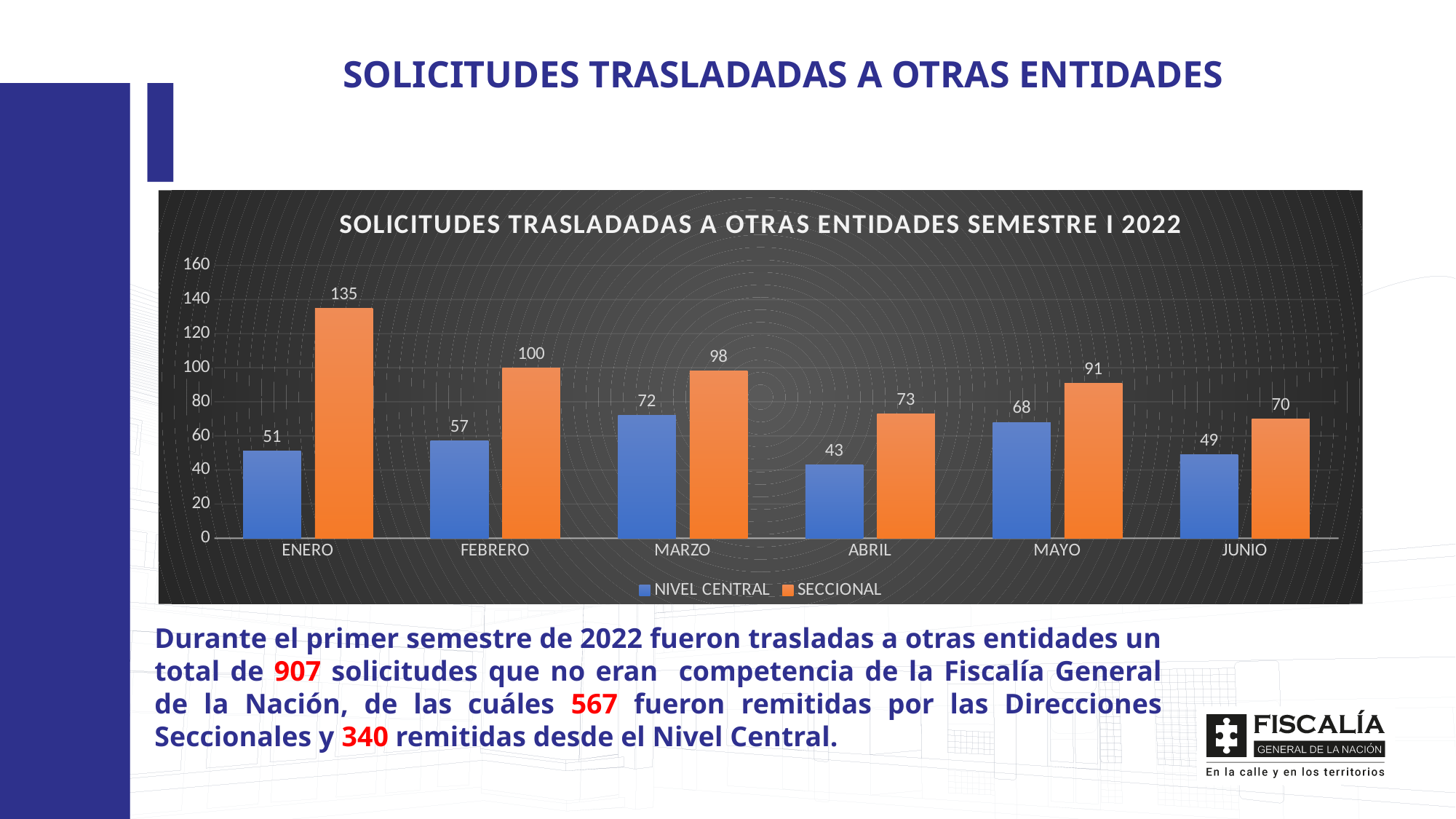
Which is larger in MARZO, NIVEL CENTRAL or SECCIONAL? SECCIONAL What is the SECCIONAL value for MAYO? 91 How many series does the legend list? 2 What kind of chart is shown? bar chart Which month has the lowest NIVEL CENTRAL value? ABRIL Which month has the highest SECCIONAL value? ENERO What is the difference between the SECCIONAL and NIVEL CENTRAL values for ENERO? 84 How many months are shown on the x axis? 6 What is the NIVEL CENTRAL value for ENERO? 51 What is the NIVEL CENTRAL value for ABRIL? 43 What is the title of the chart? SOLICITUDES TRASLADADAS A OTRAS ENTIDADES SEMESTRE I 2022 Which colour represents the SECCIONAL series? orange